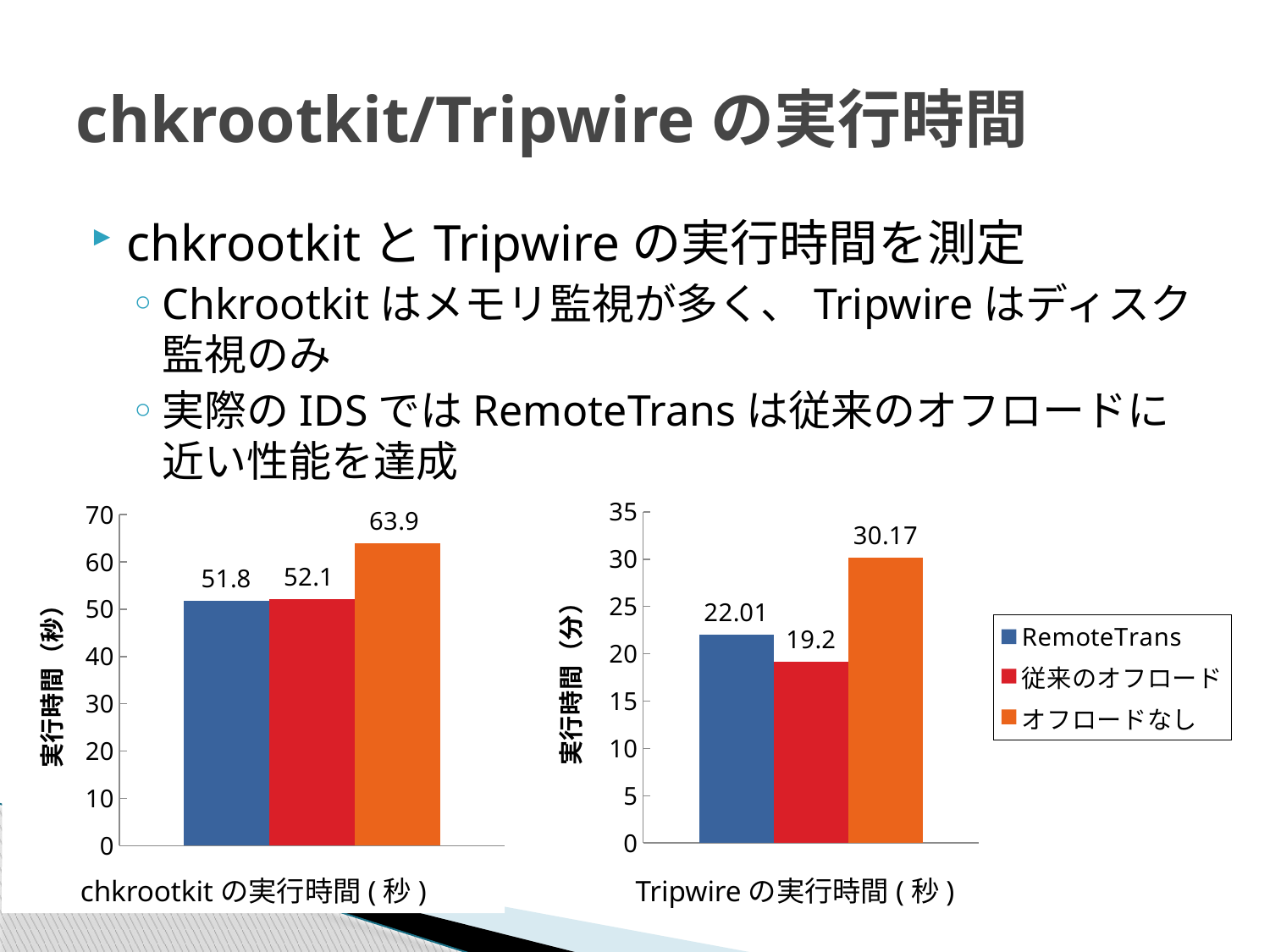
In the left chart (chkrootkit の実行時間), what is the value for RemoteTrans? 51.8 In the right chart (Tripwire の実行時間), which is larger, RemoteTrans or 従来のオフロード? RemoteTrans What kind of chart is the left chart (chkrootkit の実行時間)? Bar chart In the left chart (chkrootkit の実行時間), what is the value for オフロードなし? 63.9 In the left chart (chkrootkit の実行時間), what is the difference between オフロードなし and 従来のオフロード? 11.8 In the right chart (Tripwire の実行時間), what is the value for 従来のオフロード? 19.2 What is the y-axis label of the right chart (Tripwire の実行時間)? 実行時間（分） In the right chart (Tripwire の実行時間), which series has the lowest value? 従来のオフロード How many series does the legend list? 3 In the right chart (Tripwire の実行時間), what is the difference between オフロードなし and RemoteTrans? 8.16 In the right chart (Tripwire の実行時間), what is the value for RemoteTrans? 22.01 In the left chart (chkrootkit の実行時間), which series has the highest value? オフロードなし